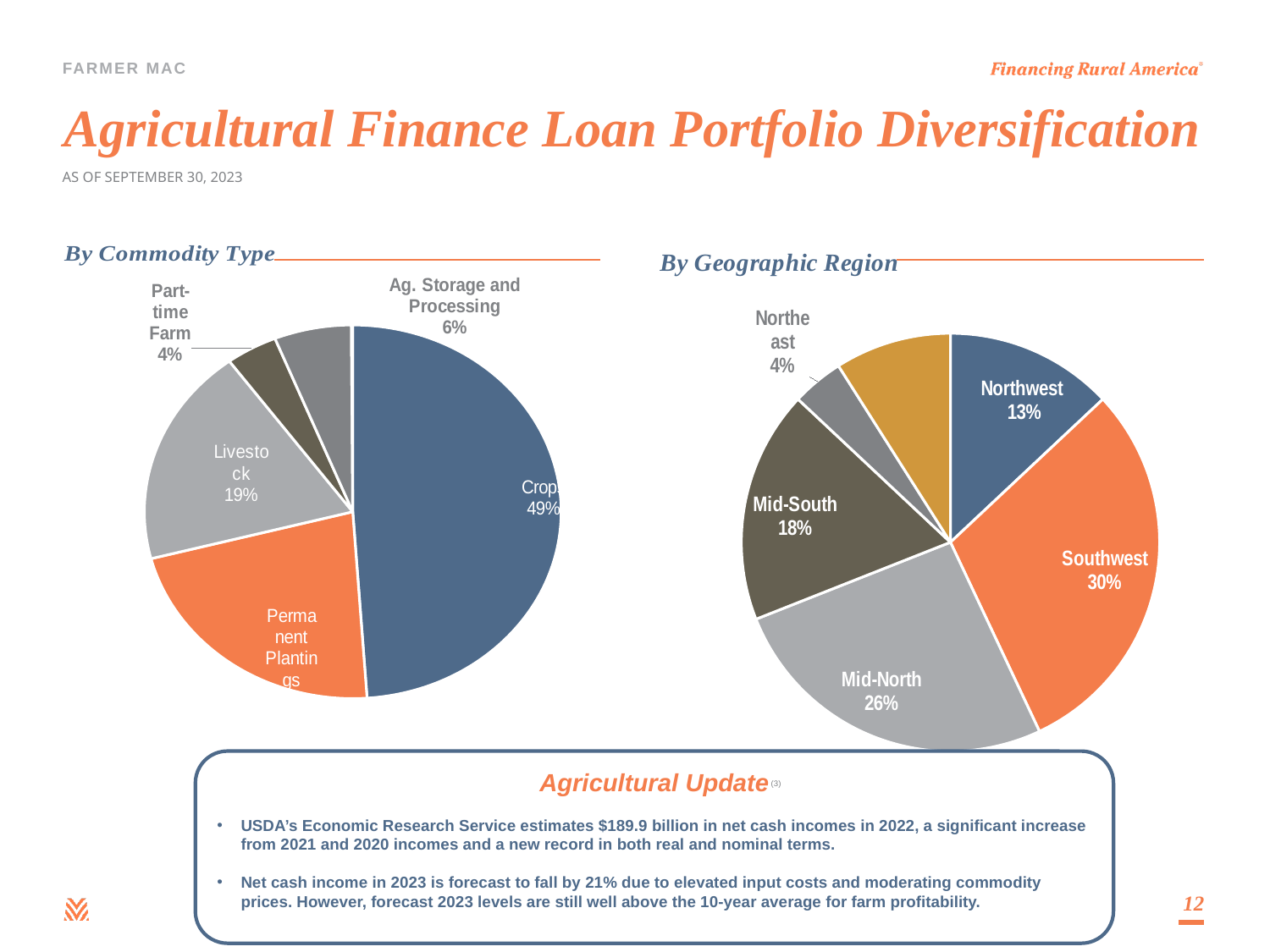
In the By Geographic Region chart, what is the difference between the Southwest and Mid-North shares? 4% In the By Geographic Region chart, what percentage is Southwest? 30% In the By Commodity Type chart, what percentage is Ag. Storage and Processing? 6% In the By Commodity Type chart, which commodity type has the largest share? Crops In the By Commodity Type chart, which is larger, Livestock or Ag. Storage and Processing? Livestock In the By Geographic Region chart, which region has the smallest labeled share? Northeast In the By Commodity Type chart, what is the difference between the Crops share and the Livestock share? 30% In the By Geographic Region chart, which is larger, Northwest or Mid-South? Mid-South In the By Geographic Region chart, what percentage is Mid-South? 18% In the By Commodity Type chart, what share is Livestock? 19% What kind of chart is the By Geographic Region chart? Pie chart In the By Commodity Type chart, what percentage is Crops? 49%